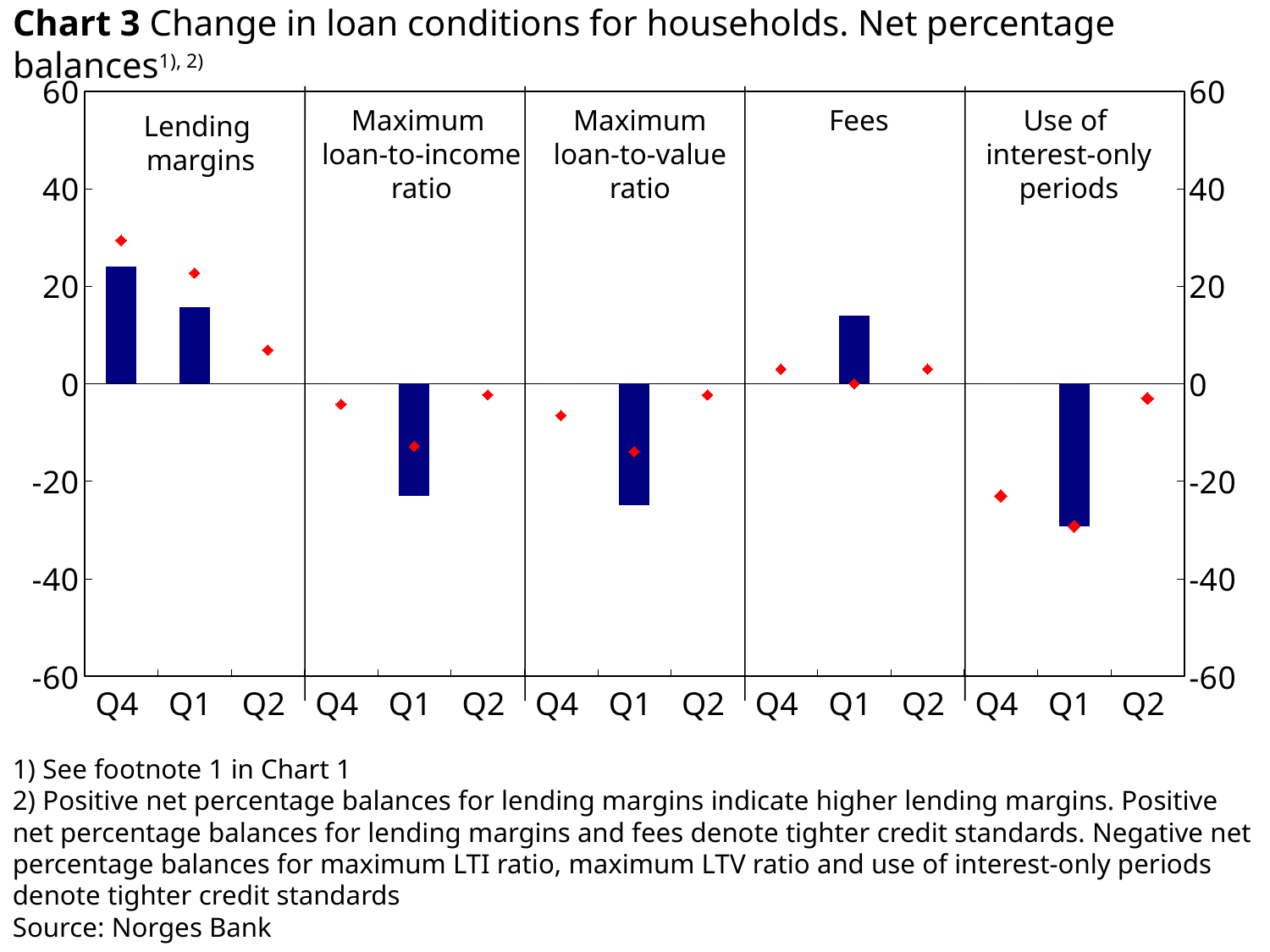
In the Lending margins panel, which bar is taller, Q4 or Q1? Q4 In the Lending margins panel, is the Q4 bar greater or less than 20? greater What is the source given for Chart 3? Norges Bank In the Lending margins panel, do the red diamond markers rise or fall from Q4 to Q2? fall In the Fees panel, is the Q1 bar greater or less than 20? less In the Use of interest-only periods panel, is the Q1 bar greater or less than -20? less Which panel contains the lowest (most negative) bar in Chart 3? Use of interest-only periods What kind of chart is Chart 3? bar chart How many quarters are shown on the x axis of each panel in Chart 3? 3 Which panel contains the tallest positive bar in Chart 3? Lending margins How many loan-condition panels does Chart 3 show? 5